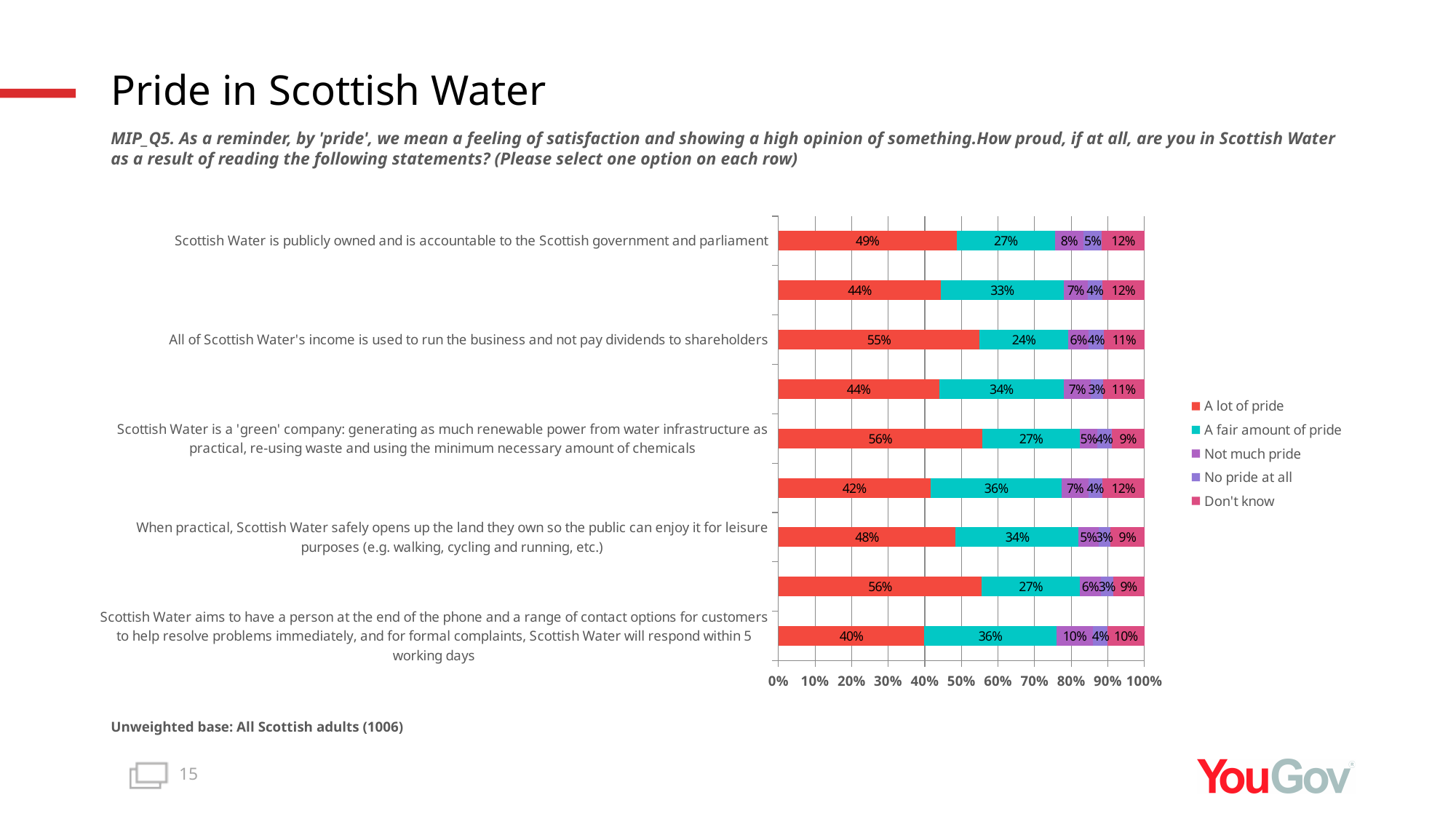
What kind of chart is shown on the slide? Stacked bar chart How many bars are plotted in the chart? 9 What is the 'No pride at all' value for the statement about Scottish Water opening up the land they own for leisure purposes? 3% For the statement that Scottish Water is publicly owned and accountable to the Scottish government and parliament, what is the difference between the 'A lot of pride' and 'A fair amount of pride' values? 22 percentage points What is the 'Don't know' value for the statement that all of Scottish Water's income is used to run the business and not pay dividends to shareholders? 11% Is the 'A lot of pride' value for the statement about Scottish Water having a person at the end of the phone greater or less than 50%? less What is the 'Not much pride' value for the statement that Scottish Water is a 'green' company? 5% What percentage of respondents feel 'A lot of pride' for the statement that Scottish Water is publicly owned and accountable to the Scottish government and parliament? 49% Which has the larger 'A lot of pride' value: the statement that Scottish Water is publicly owned, or the statement that all of Scottish Water's income is used to run the business and not pay dividends? All of Scottish Water's income is used to run the business and not pay dividends to shareholders How many series does the legend list? 5 What is the 'A fair amount of pride' value for the statement about Scottish Water aiming to have a person at the end of the phone and responding to formal complaints within 5 working days? 36%